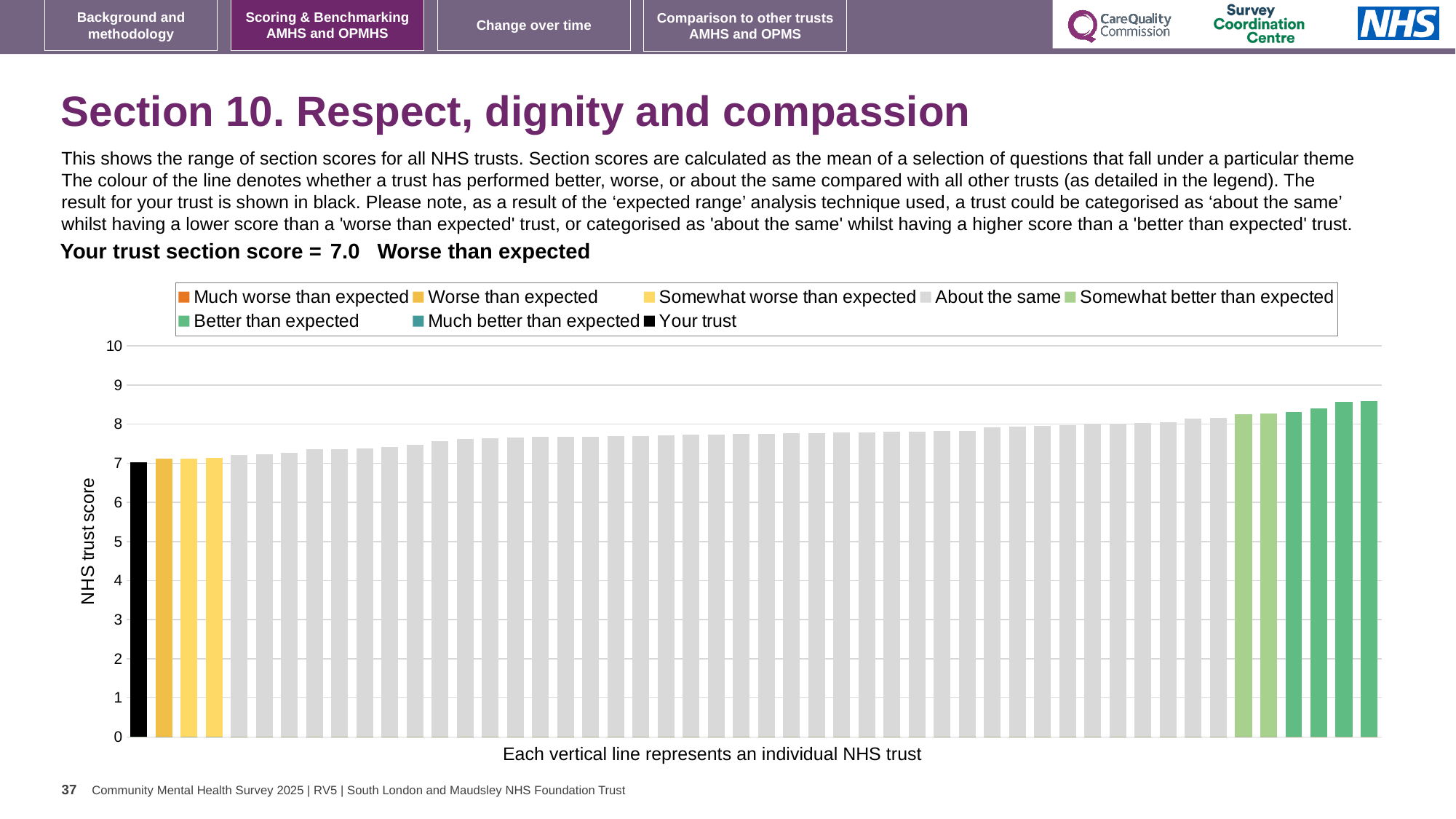
What kind of chart is shown on the slide? bar chart Do the bar values rise or fall from left to right along the x axis? rise Is the value for your trust greater or less than 8? less What colour is the bar representing your trust? black What is the label on the vertical axis of the chart? NHS trust score Is the value of the highest bar in the chart greater or less than 8? greater Which category does your trust fall into according to the slide? Worse than expected What is the section score for your trust? 7.0 Is the value of the highest bar in the chart greater or less than 9? less Which bar in the chart is the lowest? Your trust How many entries does the chart legend list? 8